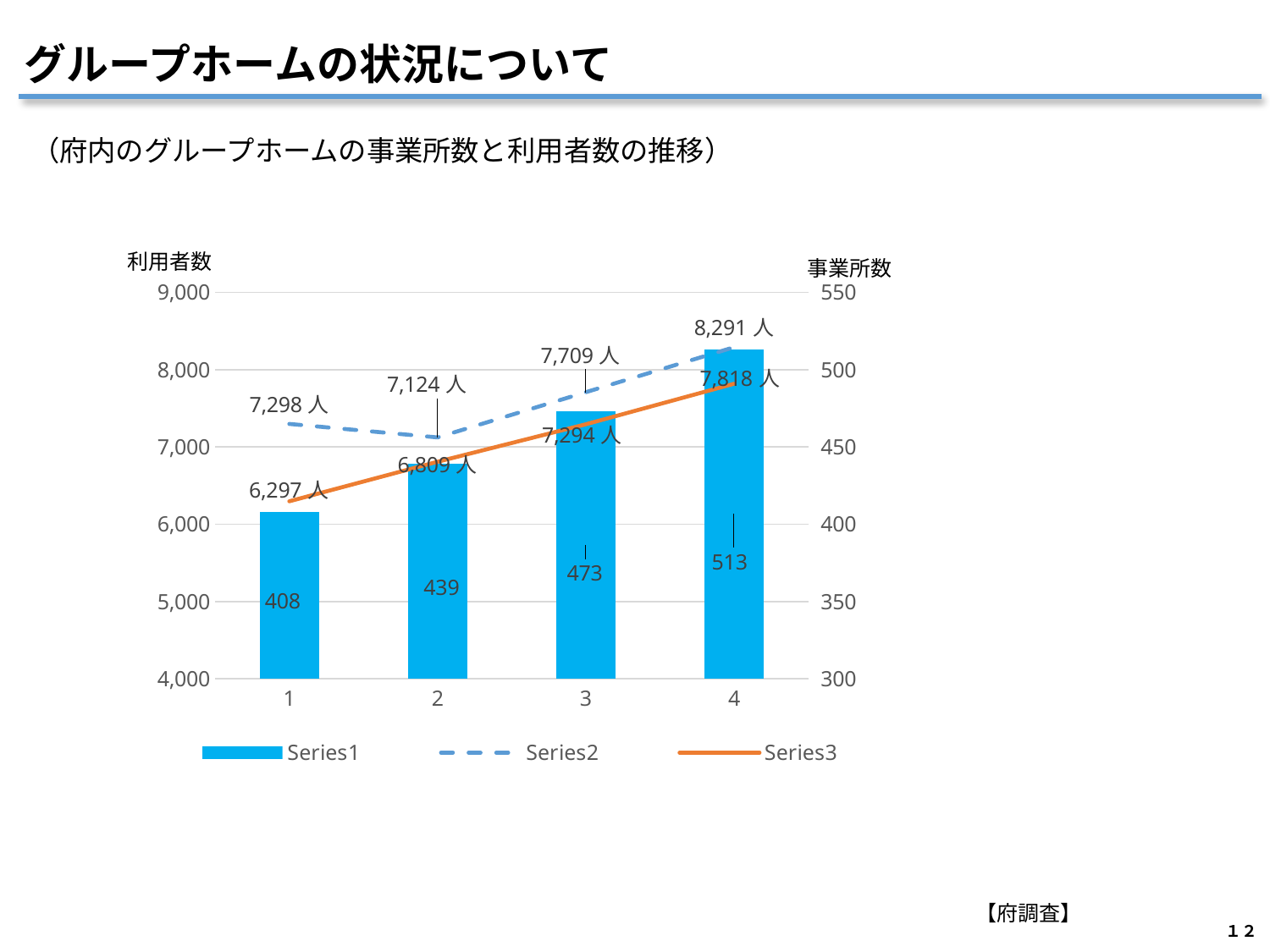
Which category has the lowest Series2 value? 2 What is the label of the right-hand (secondary) axis? 事業所数 What is the difference between the Series2 and Series3 values for category 4? 473 人 Which is larger for category 2: the Series2 value or the Series3 value? Series2 Do the Series3 values rise or fall from category 1 to category 4? rise What is the value of Series2 for category 1? 7,298 人 How many categories are shown on the x axis? 4 What is the difference between the Series1 values for category 4 and category 1? 105 What is the value of Series3 for category 3? 7,294 人 Which category has the highest Series1 value? 4 How many series does the legend list? 3 What is the value of Series1 for category 4? 513